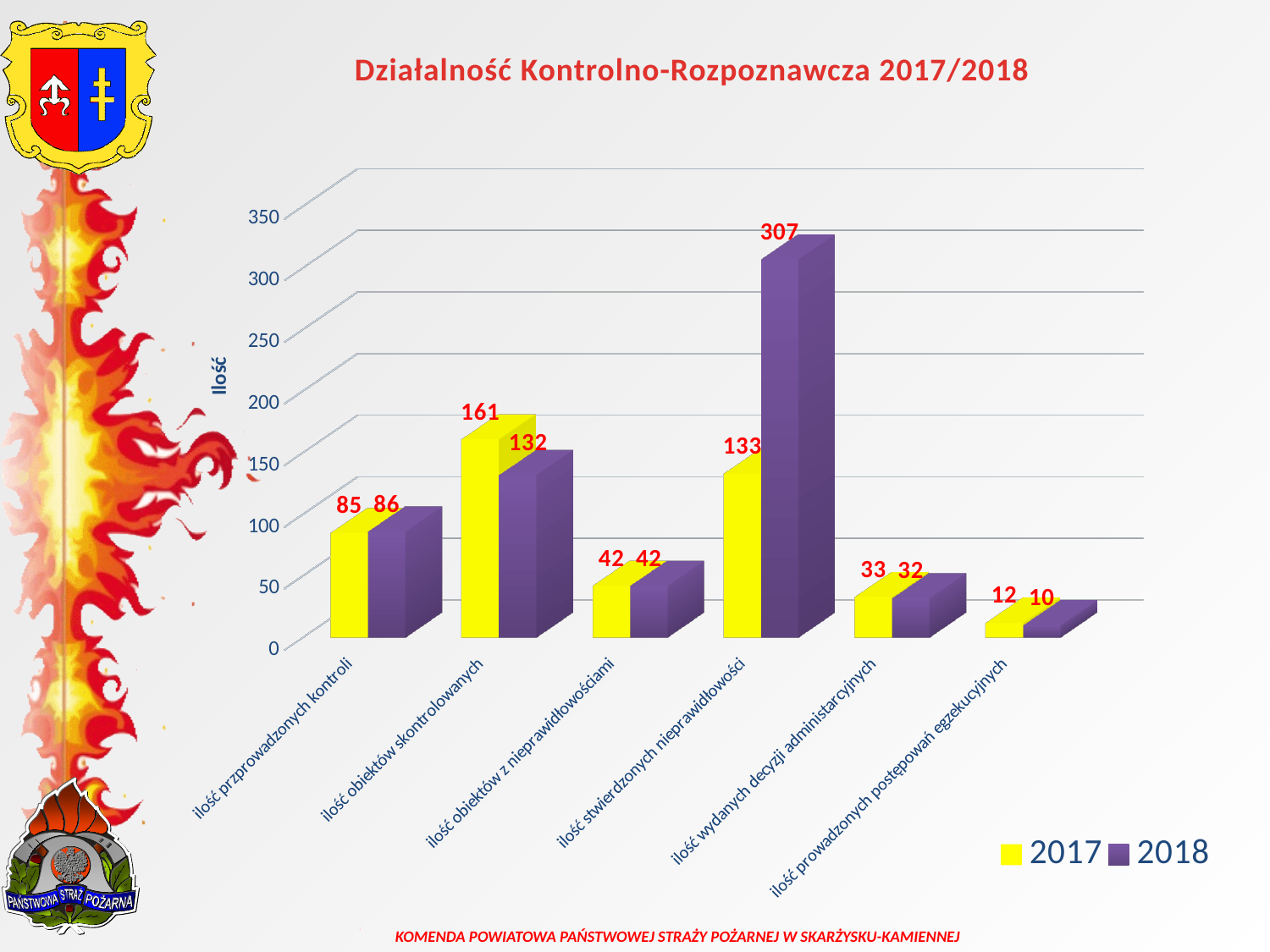
What is the difference between the 2018 and 2017 values for 'ilość stwierdzonych nieprawidłowości'? 174 What is the 2017 value for 'ilość obiektów skontrolowanych'? 161 Which is larger for 'ilość obiektów skontrolowanych': the 2017 value or the 2018 value? 2017 Which category has the lowest 2017 value? ilość prowadzonych postępowań egzekucyjnych What type of chart is shown on the slide? bar chart What is the 2017 value for 'ilość prowadzonych postępowań egzekucyjnych'? 12 What is the 2018 value for 'ilość stwierdzonych nieprawidłowości'? 307 Which colour represents the 2018 series in the legend? purple How many categories are shown on the x axis? 6 What is the title of the chart? Działalność Kontrolno-Rozpoznawcza 2017/2018 How many series does the legend list? 2 Which category has the highest 2018 value? ilość stwierdzonych nieprawidłowości